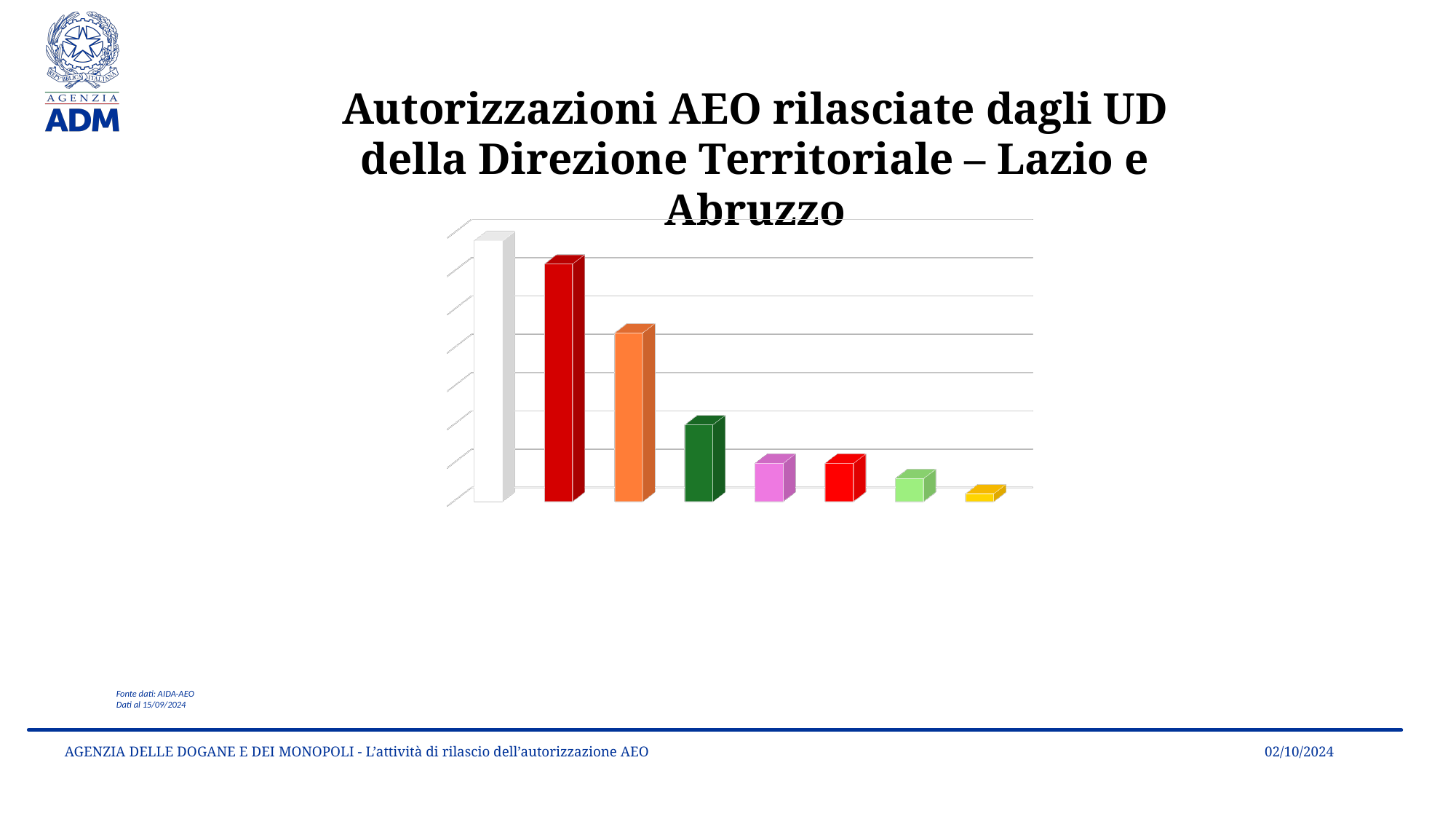
Which bar is the shortest in the chart? the yellow bar on the far right Which bar is the tallest in the chart? the white bar on the far left What kind of chart is shown on the slide? bar chart Which bar is the tallest in the chart, the white one on the far left or the yellow one on the far right? the white one on the far left Do the bar values rise or fall from left to right across the chart? fall How many bars does the chart contain? 8 Is the dark red bar taller or shorter than the orange bar? taller What is the title of the chart? Autorizzazioni AEO rilasciate dagli UD della Direzione Territoriale – Lazio e Abruzzo